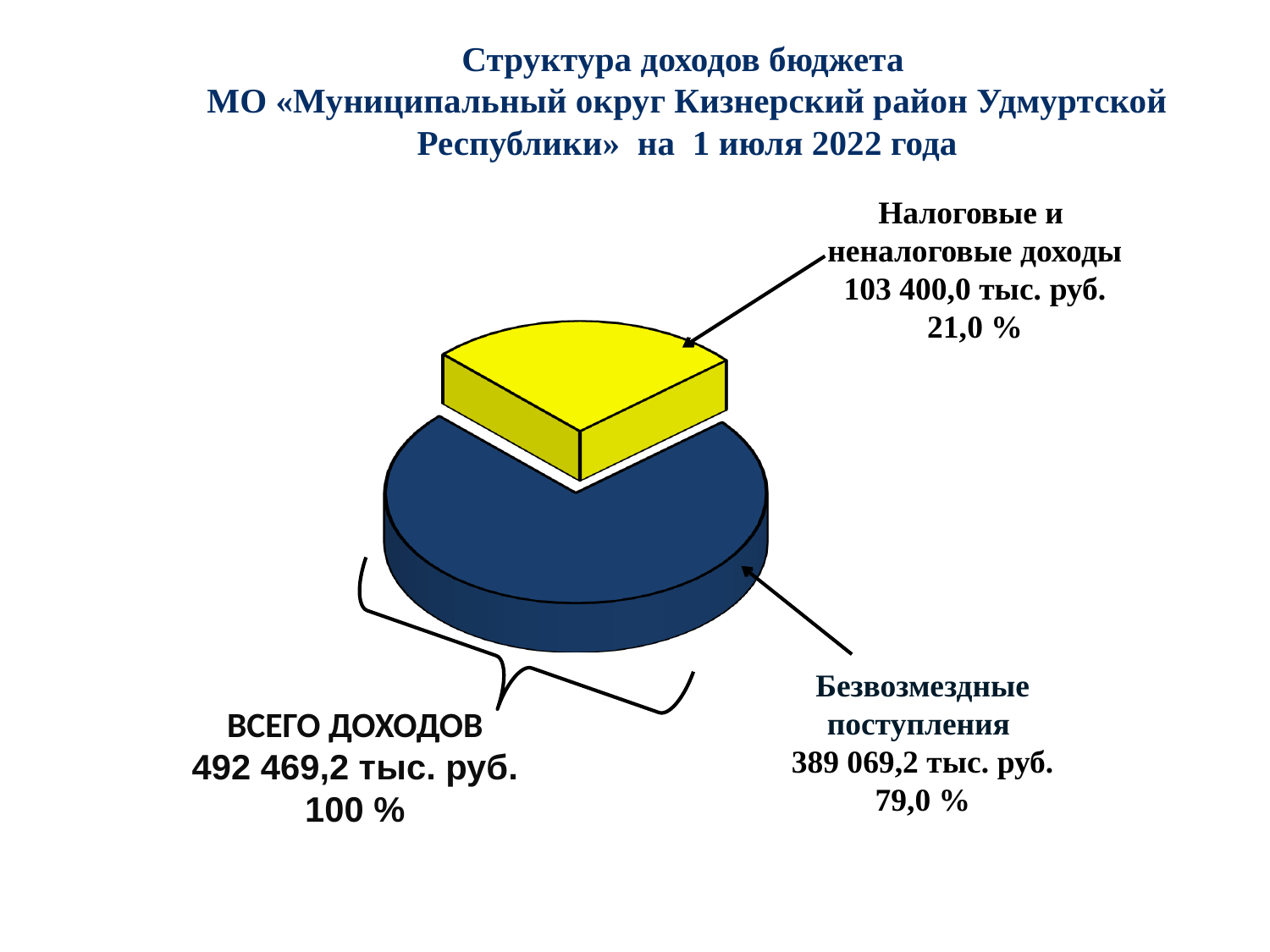
What share of the pie does «Безвозмездные поступления» represent? 79,0 % What is the value for «Безвозмездные поступления»? 389 069,2 тыс. руб. How many slices does the pie chart have? 2 What is the value for «Налоговые и неналоговые доходы»? 103 400,0 тыс. руб. Which slice of the pie is the largest? Безвозмездные поступления What is the total of all income shown on the chart (ВСЕГО ДОХОДОВ)? 492 469,2 тыс. руб. Which slice of the pie is the smallest? Налоговые и неналоговые доходы What is the difference between «Безвозмездные поступления» and «Налоговые и неналоговые доходы» in тыс. руб.? 285 669,2 тыс. руб. What kind of chart is shown on the slide? pie chart What colour is the slice for «Налоговые и неналоговые доходы»? yellow What share of the pie does «Налоговые и неналоговые доходы» represent? 21,0 % Which is larger: «Безвозмездные поступления» or «Налоговые и неналоговые доходы»? Безвозмездные поступления